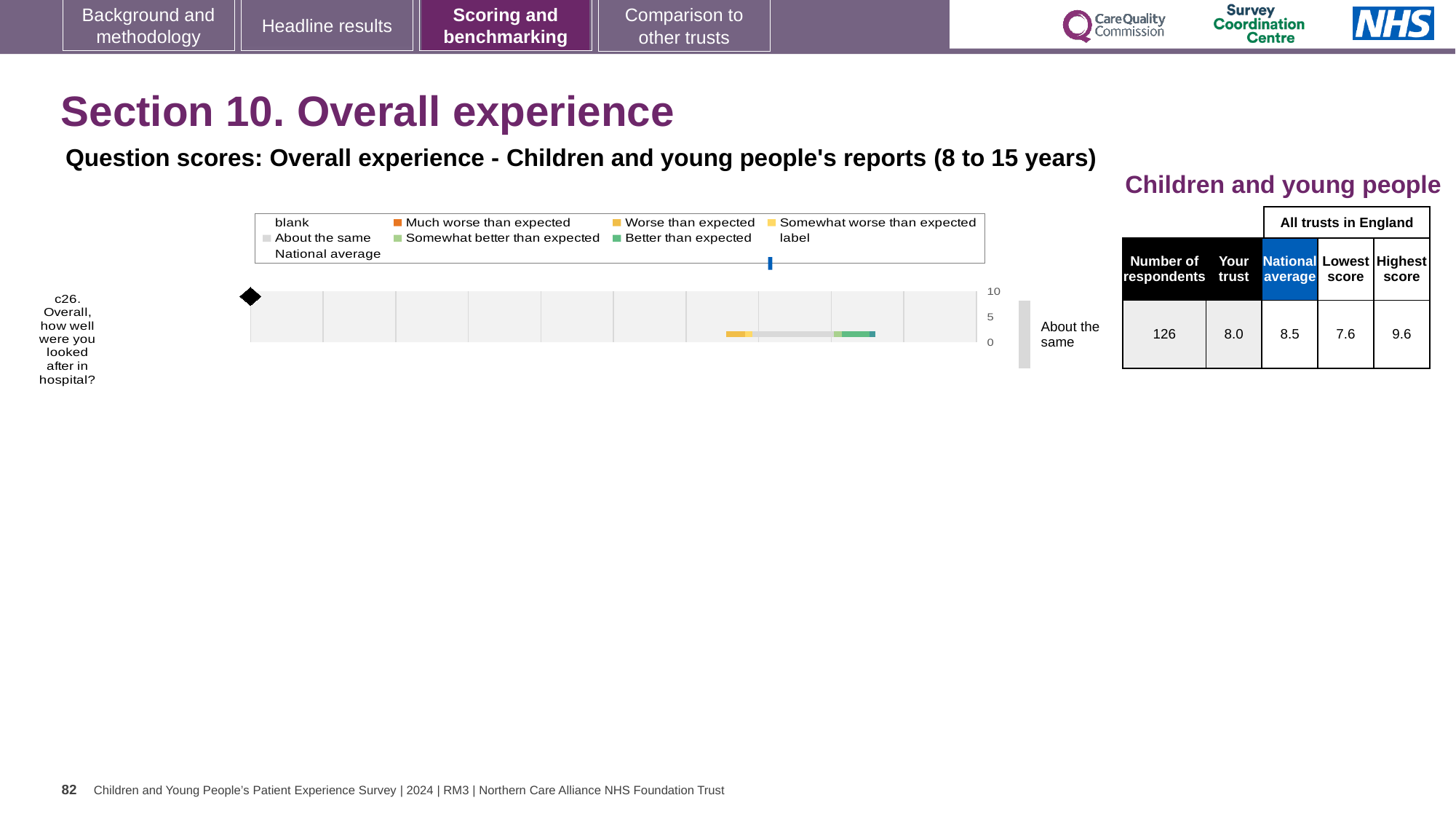
What is the highest score among all trusts in England for question c26? 9.6 What is the national average score for question c26? 8.5 What is the full wording of question c26 shown on the chart? Overall, how well were you looked after in hospital? What is the lowest score among all trusts in England for question c26? 7.6 What is the 'Your trust' score for question c26? 8.0 How many respondents answered question c26? 126 What is the difference between the highest score and the lowest score for question c26? 2.0 How many survey questions are plotted in the chart? 1 What kind of chart is shown on the slide? bar chart Which legend entry is represented by the blue marker in the chart? National average Which is larger for question c26: the 'Your trust' score or the national average? National average What benchmark category is the trust's result for question c26 placed in? About the same